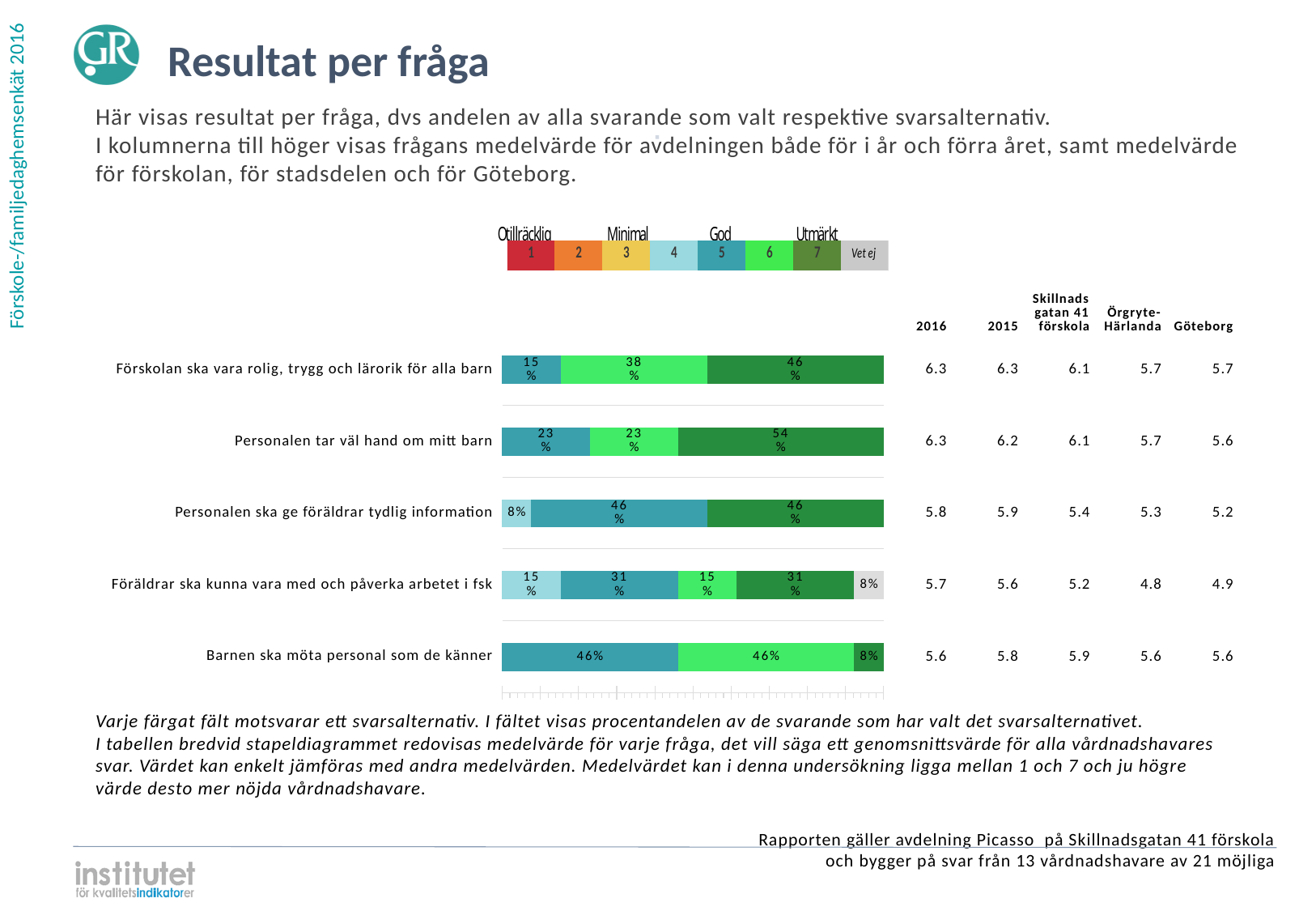
How many questions (categories) are shown in the bar chart? 5 What is the difference between the rating 7 share for "Personalen tar väl hand om mitt barn" (54%) and for "Förskolan ska vara rolig, trygg och lärorik för alla barn" (46%)? 8% Which question has the smallest share of respondents choosing rating 7 (dark green)? Barnen ska möta personal som de känner What is the 2016 mean value shown for "Personalen ska ge föräldrar tydlig information"? 5.8 What percentage of respondents chose rating 6 (light green) for "Förskolan ska vara rolig, trygg och lärorik för alla barn"? 38% What percentage of respondents chose rating 7 (dark green) for "Personalen tar väl hand om mitt barn"? 54% Which question has the largest share of respondents choosing rating 7 (dark green)? Personalen tar väl hand om mitt barn For "Barnen ska möta personal som de känner", is the share for rating 5 (teal) larger or smaller than the share for rating 7 (dark green)? Larger Which rating label in the legend corresponds to the value 7? Utmärkt What kind of chart is used to show the share of respondents per answer alternative? Stacked bar chart What is the combined share of ratings 6 and 7 for "Förskolan ska vara rolig, trygg och lärorik för alla barn"? 84% What percentage of respondents answered "Vet ej" for "Föräldrar ska kunna vara med och påverka arbetet i fsk"? 8%